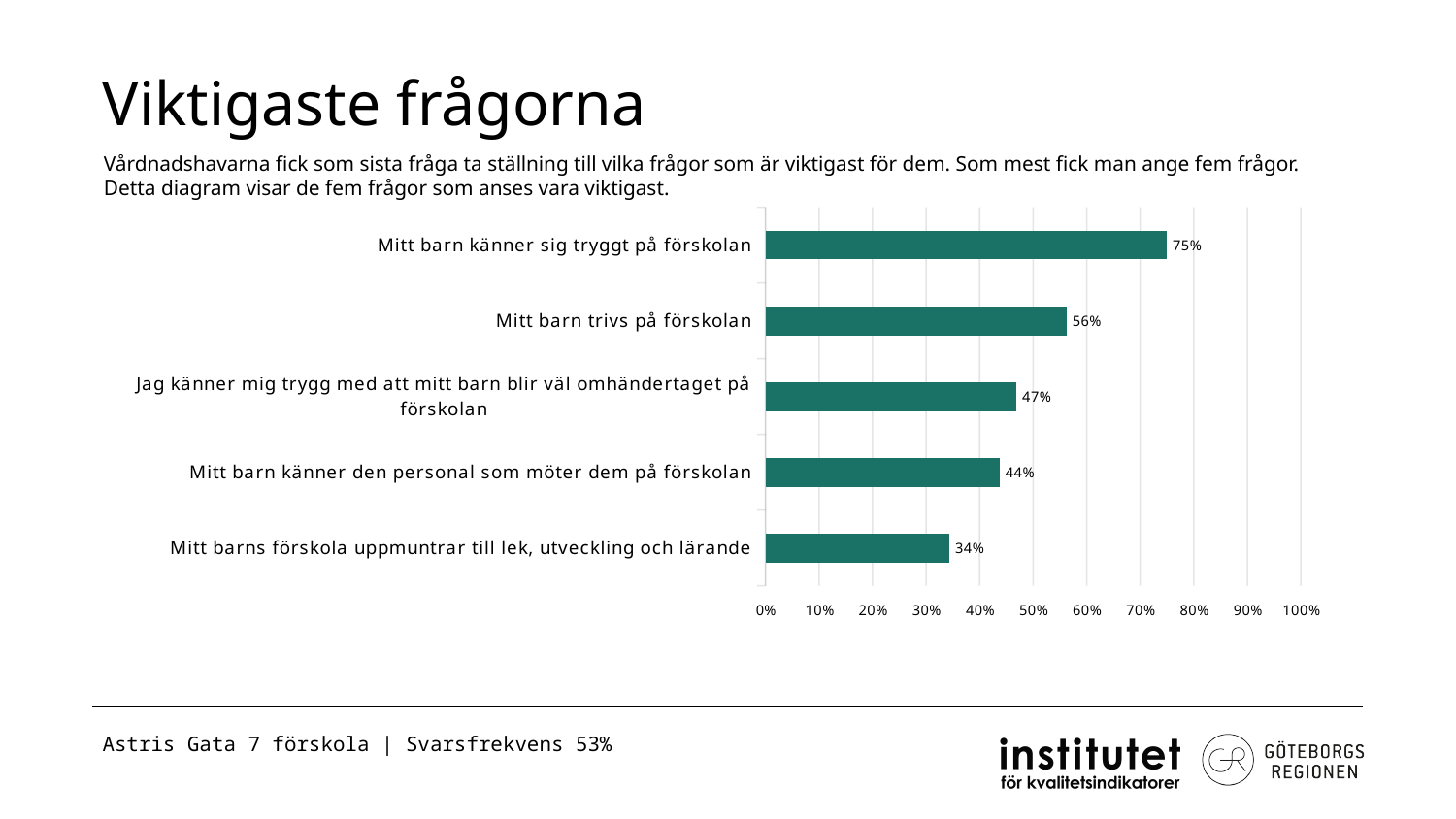
Which category has the lowest value? Mitt barns förskola uppmuntrar till lek, utveckling och lärande Is the value for "Mitt barn trivs på förskolan" greater or less than 50%? greater What is the title of the slide containing the chart? Viktigaste frågorna Which category has the highest value? Mitt barn känner sig tryggt på förskolan Which is larger: the value for "Jag känner mig trygg med att mitt barn blir väl omhändertaget på förskolan" or for "Mitt barn känner den personal som möter dem på förskolan"? Jag känner mig trygg med att mitt barn blir väl omhändertaget på förskolan What is the value for "Mitt barn trivs på förskolan"? 56% What is the value for "Mitt barns förskola uppmuntrar till lek, utveckling och lärande"? 34% How many categories are shown in the chart? 5 What is the value for "Mitt barn känner den personal som möter dem på förskolan"? 44% What kind of chart is shown on the slide? bar chart What is the difference between the values for "Mitt barn känner sig tryggt på förskolan" and "Mitt barn trivs på förskolan"? 19% What is the value for "Mitt barn känner sig tryggt på förskolan"? 75%